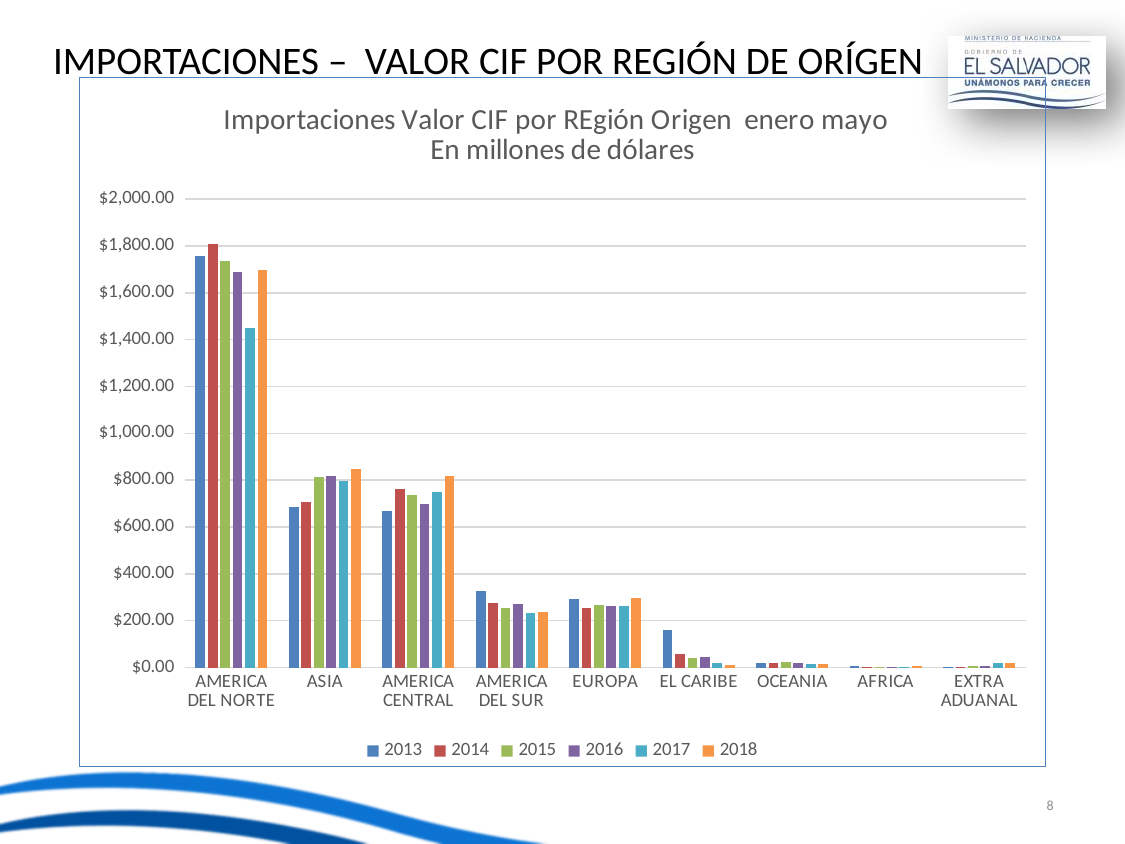
Is the 2013 value for AMERICA DEL SUR greater or less than $400.00? less What kind of chart is shown on the slide? bar chart How many regions are shown on the x axis? 9 How many series does the legend list? 6 For EL CARIBE, do the values rise or fall from 2013 to 2018? fall Which region has the highest import values? AMERICA DEL NORTE Is the 2018 value for ASIA greater or less than $800.00? greater Is the 2013 value for AMERICA CENTRAL greater or less than $600.00? greater For ASIA, which is larger: the 2013 value or the 2018 value? 2018 Within AMERICA DEL NORTE, which year has the lowest bar? 2017 What unit does the chart title say the values are in? millones de dólares